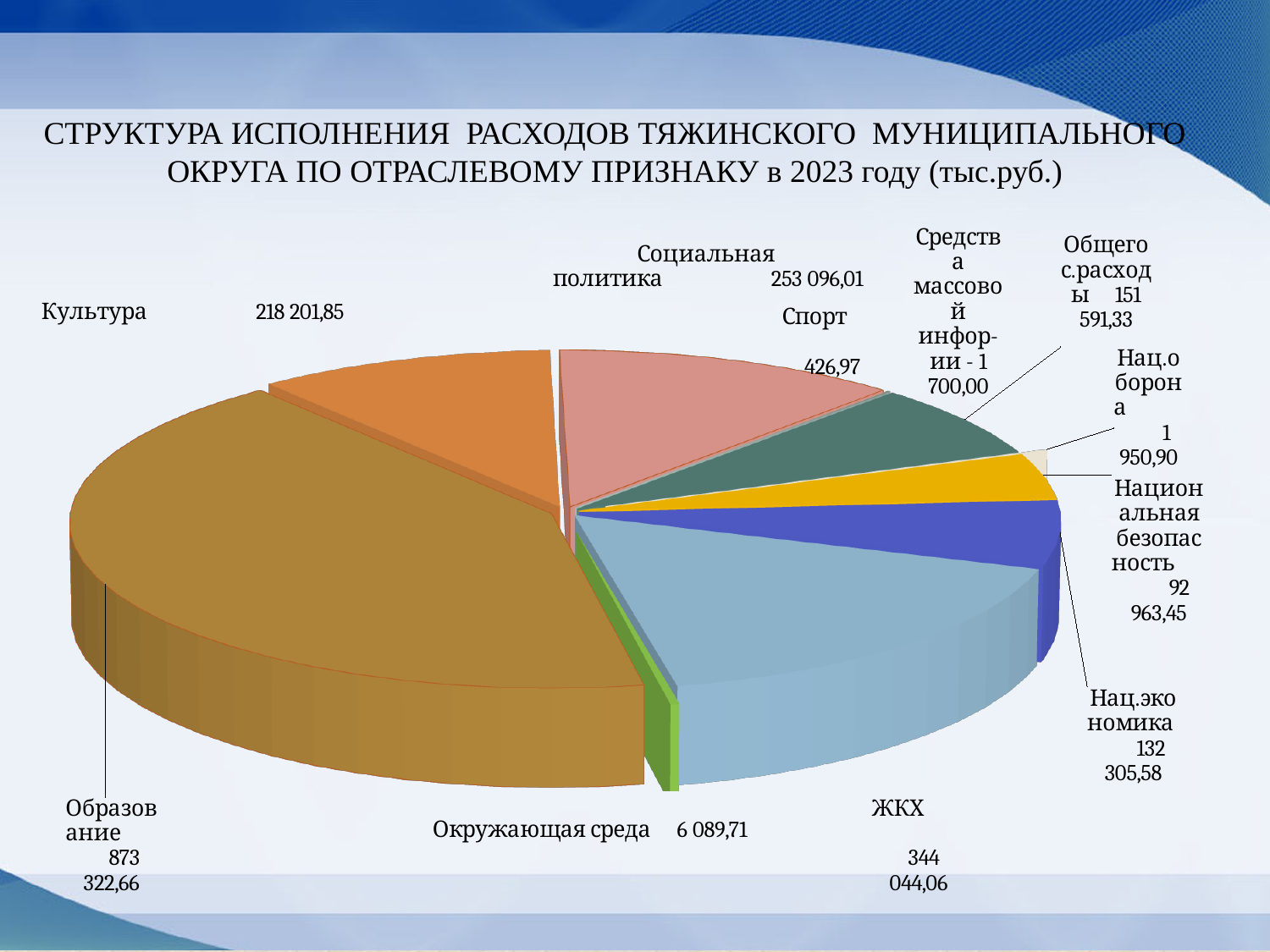
Which is larger, Общегос.расходы or Национальная безопасность? Общегос.расходы What is the value for Социальная политика? 253 096,01 What is the difference between ЖКХ and Нац.экономика? 211 738,48 Which category has the lowest value? Спорт Which category has the highest value? Образование How many categories are shown in the pie chart? 11 What is the difference between Социальная политика and Культура? 34 894,16 What is the value for Окружающая среда? 6 089,71 What is the value for Нац.экономика? 132 305,58 What kind of chart is shown on the slide? Pie chart What is the value for Образование? 873 322,66 What is the value for ЖКХ? 344 044,06